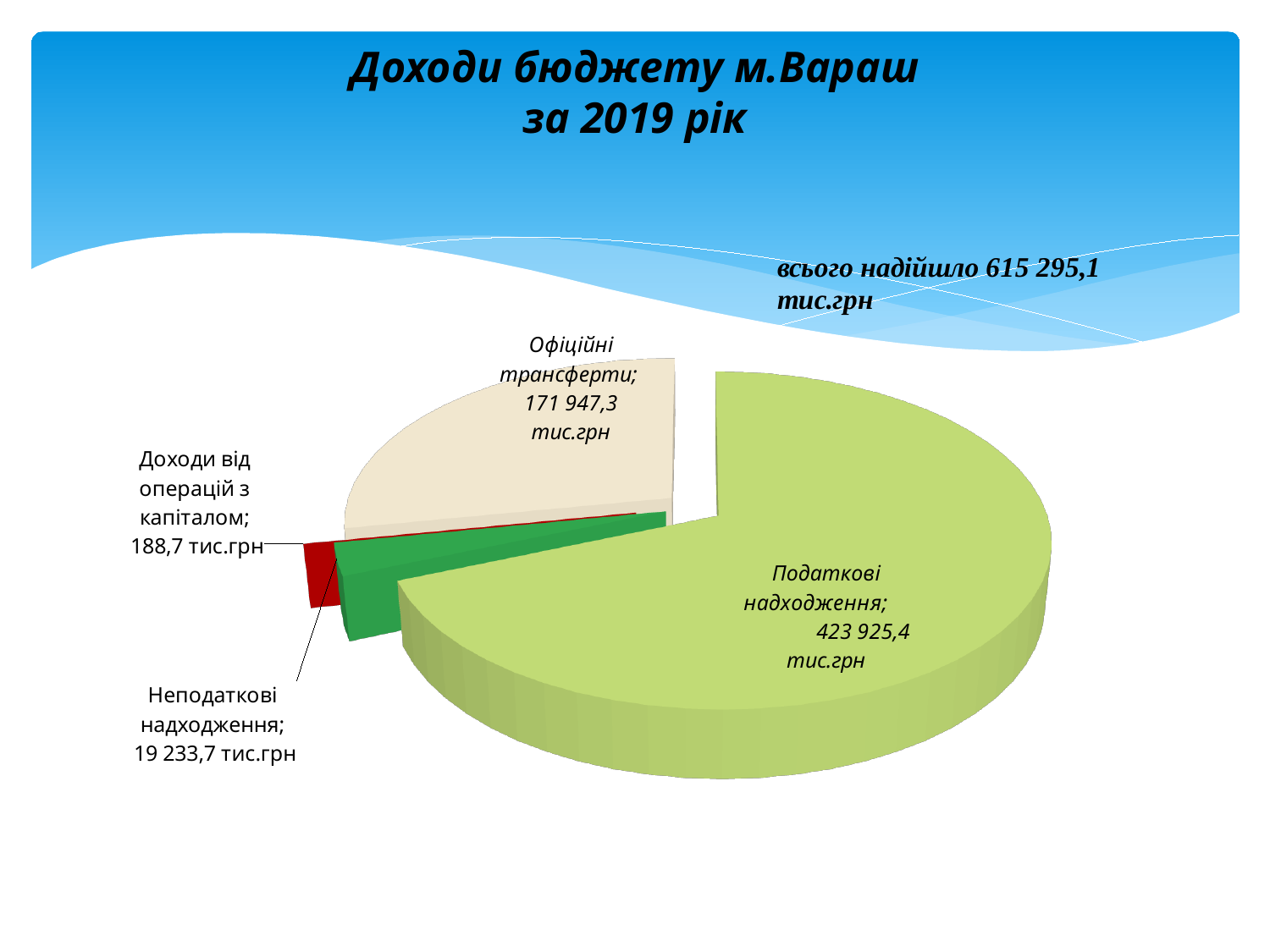
What total amount of revenue does the slide state was received? 615 295,1 тис.грн What is the value for Неподаткові надходження? 19 233,7 тис.грн Which category has the largest slice of the pie? Податкові надходження What is the difference between Податкові надходження and Офіційні трансферти? 251 978,1 тис.грн What is the value for Офіційні трансферти? 171 947,3 тис.грн How many slices does the pie chart have? 4 Which category has the smallest slice of the pie? Доходи від операцій з капіталом What kind of chart is shown on the slide? Pie chart What is the value for Податкові надходження? 423 925,4 тис.грн What is the value for Доходи від операцій з капіталом? 188,7 тис.грн What is the title of the slide? Доходи бюджету м.Вараш за 2019 рік Which is larger, Офіційні трансферти or Неподаткові надходження? Офіційні трансферти